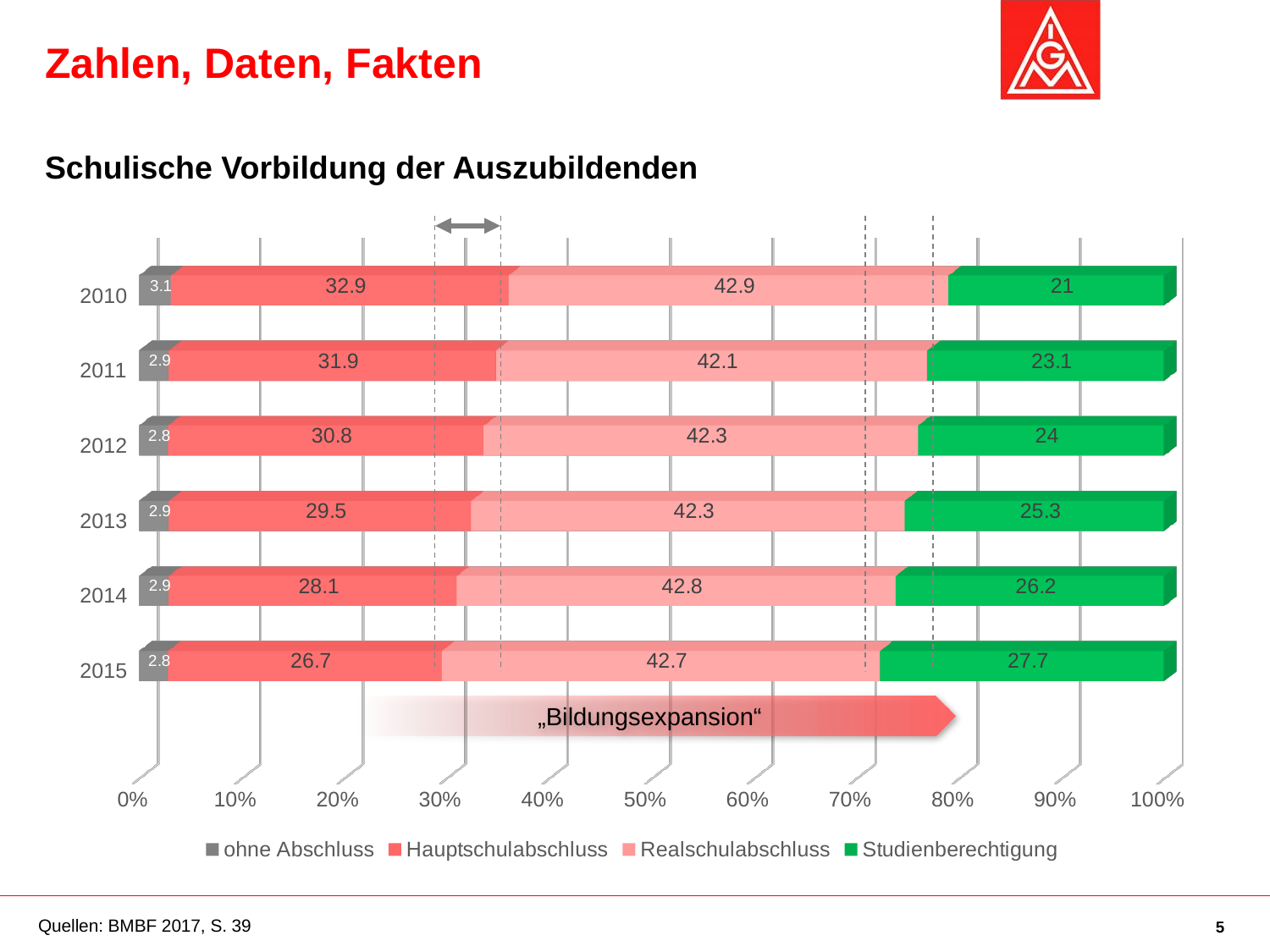
How many series does the legend list? 4 What is the Studienberechtigung value for 2015? 27.7 What is the ohne Abschluss value for 2010? 3.1 What is the Realschulabschluss value for 2013? 42.3 Does the Hauptschulabschluss value rise or fall from 2010 to 2015? Fall In which year is the Studienberechtigung value highest? 2015 Which is larger, the Hauptschulabschluss value for 2012 or for 2014? 2012 In which year is the Hauptschulabschluss value lowest? 2015 How many years are shown on the chart? 6 What is the difference between the Studienberechtigung values for 2015 and 2010? 6.7 What kind of chart is shown? Stacked bar chart What is the Hauptschulabschluss value for 2010? 32.9